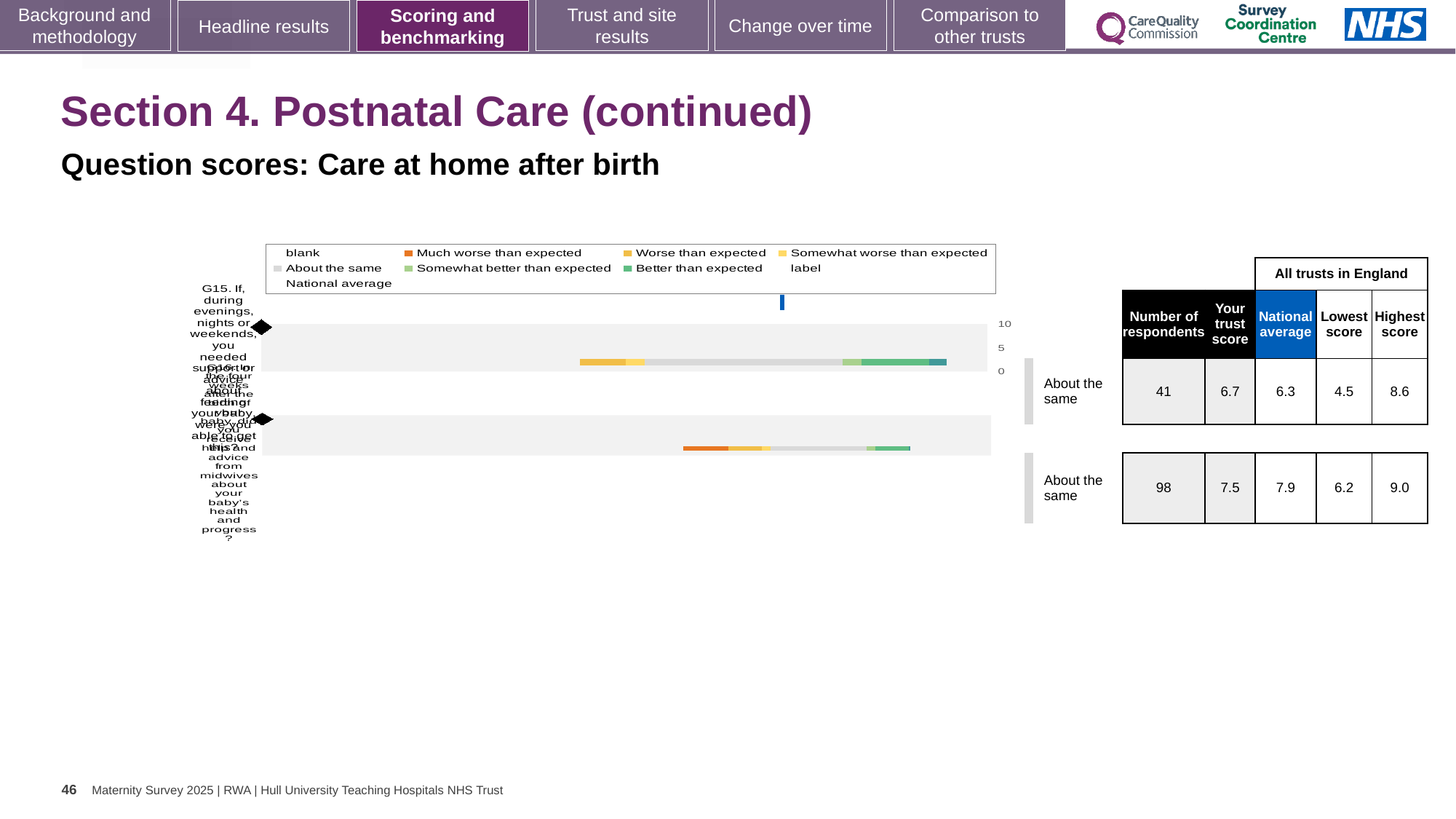
What kind of chart is shown on the slide? bar chart For the top row, which is larger: the trust score or the national average? the trust score In the table beside the chart, what is the national average for the bottom row? 7.9 In the table beside the chart, what is the lowest score for the top row? 4.5 In the table beside the chart, what is the trust score for the top row? 6.7 What benchmark category label is shown next to both rows of the chart? About the same In the table beside the chart, what is the highest score for the bottom row? 9.0 How many question rows are plotted in the chart? 2 In the table beside the chart, what is the number of respondents for the top row? 41 What is the difference in the number of respondents between the bottom row and the top row? 57 For the bottom row, which is larger: the trust score or the national average? the national average For the bottom row, what is the difference between the highest score and the lowest score? 2.8